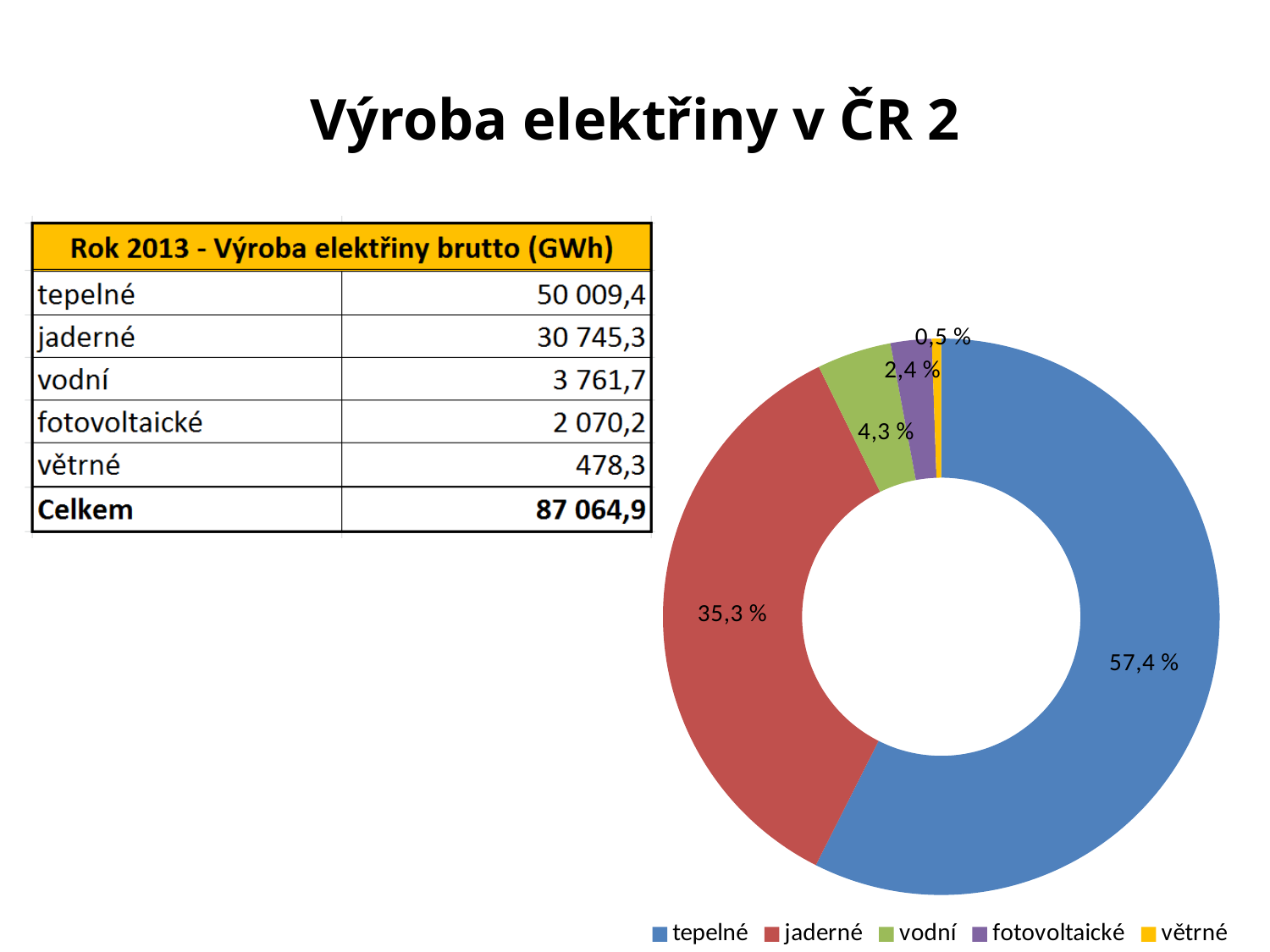
What percentage is shown for the větrné slice in the chart? 0,5 % Which slice is larger, vodní or fotovoltaické? vodní What percentage is shown for the fotovoltaické slice in the chart? 2,4 % What is the difference in percentage points between the tepelné and jaderné slices? 22,1 % Which category has the largest slice in the chart? tepelné What kind of chart is shown on the slide? doughnut (pie) chart Which category has the smallest slice in the chart? větrné What share of the doughnut chart does the jaderné slice represent? 35,3 % How many categories does the legend of the chart list? 5 What share of the doughnut chart does the tepelné slice represent? 57,4 % What percentage is shown for the vodní slice in the chart? 4,3 % What colour is used for the jaderné slice in the chart? red